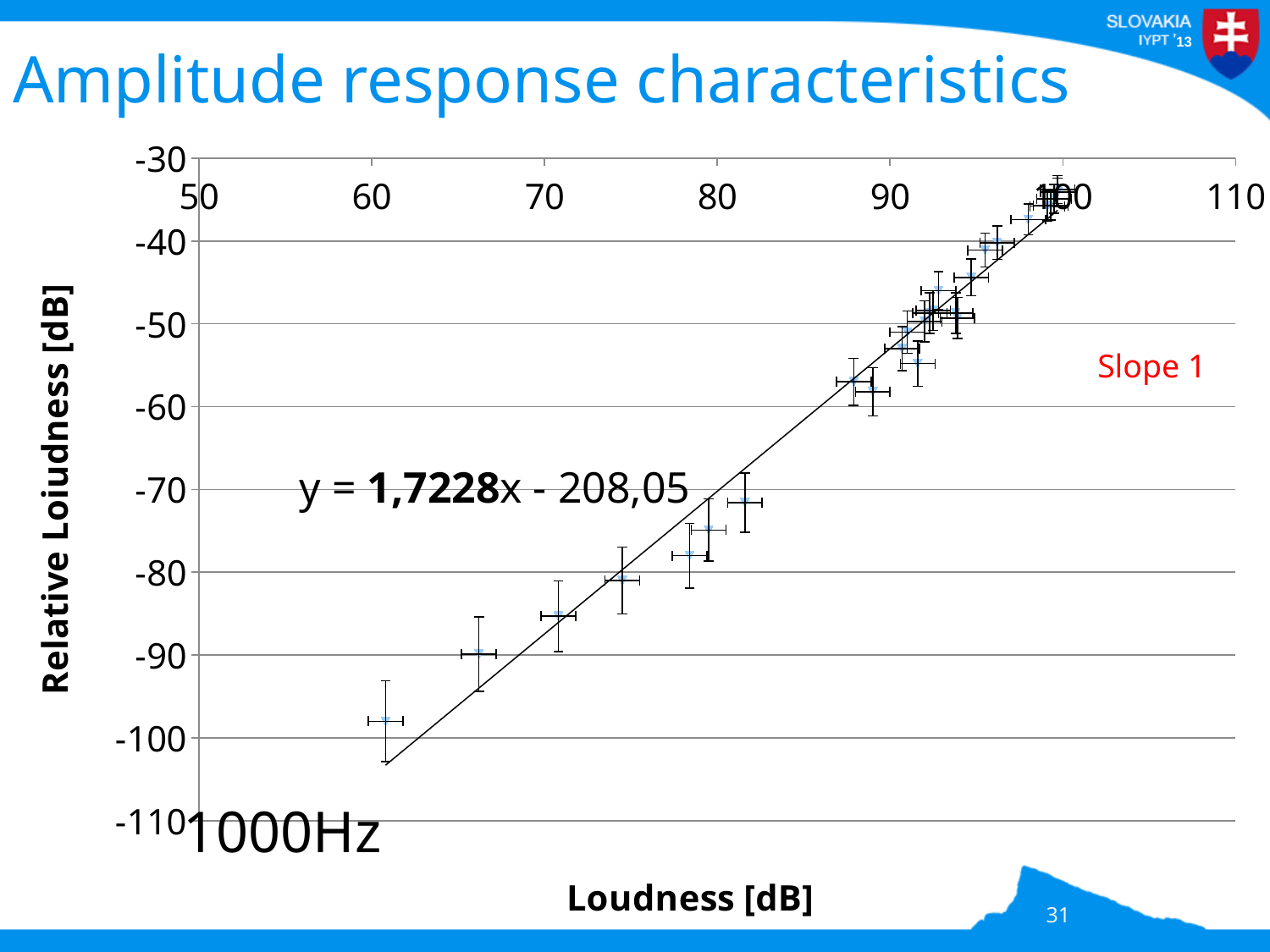
Is the Relative Loudness value of the data point near 81 dB Loudness greater or less than -80? greater Is the Relative Loudness value of the leftmost data point (near 61 dB Loudness) greater or less than -90? less Is the Relative Loudness value of the data point near 71 dB Loudness greater or less than -80? less What is the full trendline equation printed on the chart? y = 1,7228x - 208,05 What is the label on the x axis of the chart? Loudness [dB] Do the plotted values of Relative Loudness rise or fall as Loudness increases along the x axis? rise What is the slope coefficient in the fitted line equation shown on the chart? 1,7228 Which data point has the lowest Relative Loudness value: the one near 61 dB Loudness or the one near 88 dB Loudness? the one near 61 dB What kind of chart is shown on the slide? scatter chart